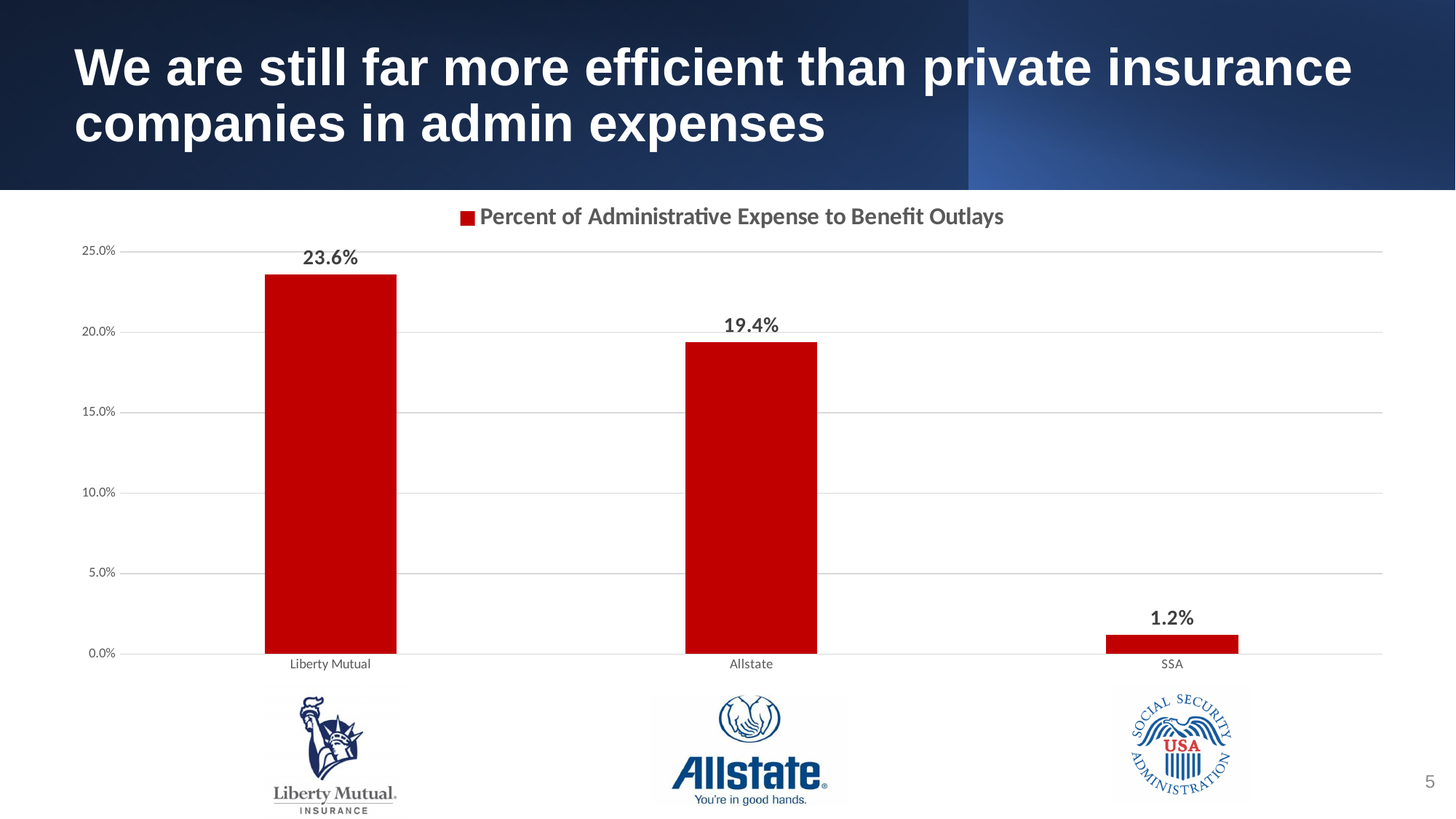
What is the value for Liberty Mutual? 23.6% What series name does the legend show? Percent of Administrative Expense to Benefit Outlays How many categories are shown in the chart? 3 Which category has the lowest value? SSA What is the difference between the values for Allstate and SSA? 18.2% What is the value for Allstate? 19.4% What is the value for SSA? 1.2% What kind of chart is shown on the slide? bar chart Which category has the highest value? Liberty Mutual Is the value for Allstate greater or less than 20.0%? less Which is larger, the value for Allstate or the value for SSA? Allstate What is the difference between the values for Liberty Mutual and Allstate? 4.2%